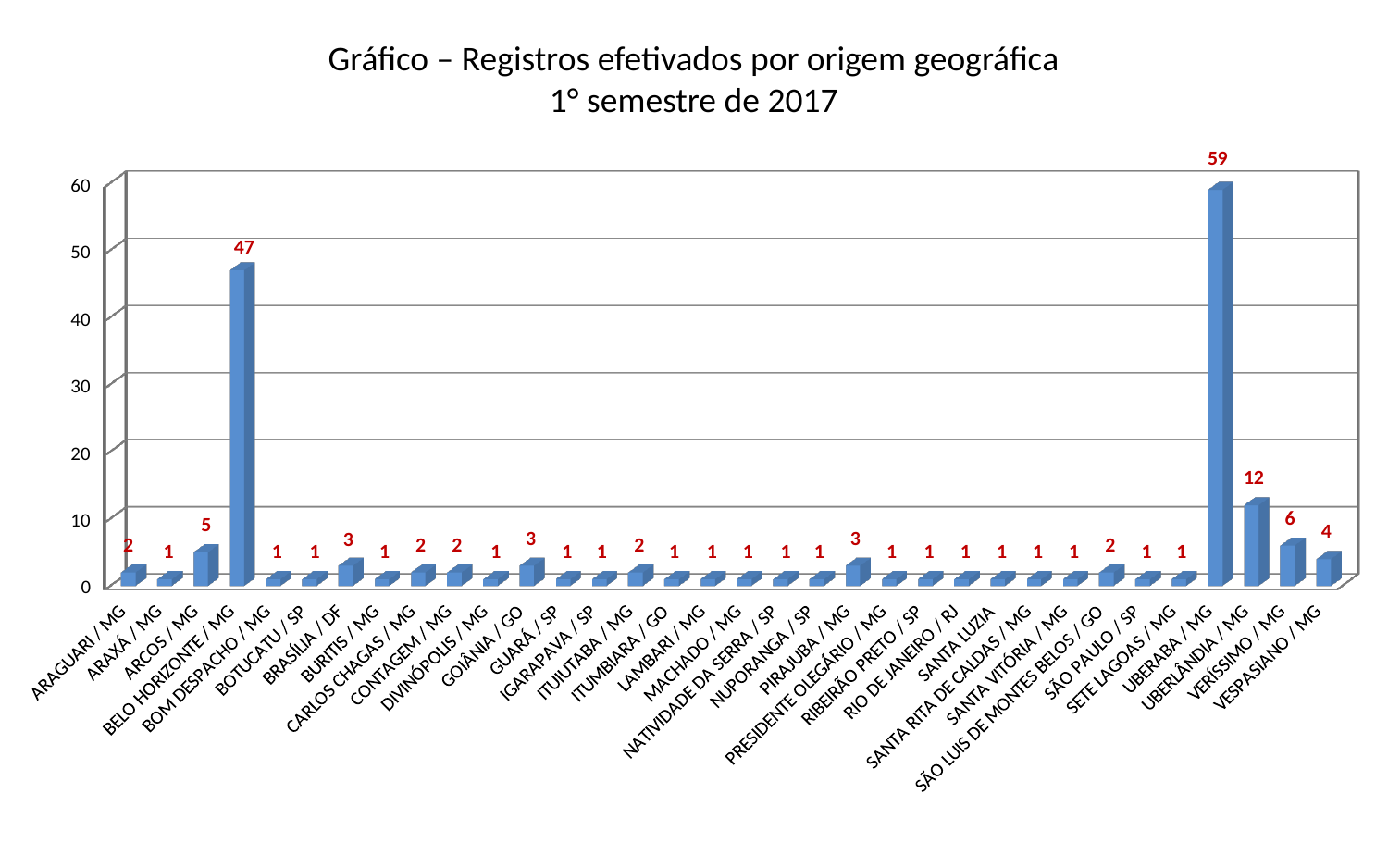
How many categories are shown on the x axis? 34 Which is larger, the value for ARCOS / MG or the value for VESPASIANO / MG? ARCOS / MG Which category has the highest value? UBERABA / MG What kind of chart is shown on the slide? bar chart Is the value for BELO HORIZONTE / MG greater or less than 40? greater What is the difference between the values for UBERABA / MG and BELO HORIZONTE / MG? 12 What is the value for VERÍSSIMO / MG? 6 What is the value for UBERABA / MG? 59 What is the value for BELO HORIZONTE / MG? 47 What is the title of the chart? Gráfico – Registros efetivados por origem geográfica 1° semestre de 2017 What is the difference between the values for UBERLÂNDIA / MG and VESPASIANO / MG? 8 What is the value for UBERLÂNDIA / MG? 12